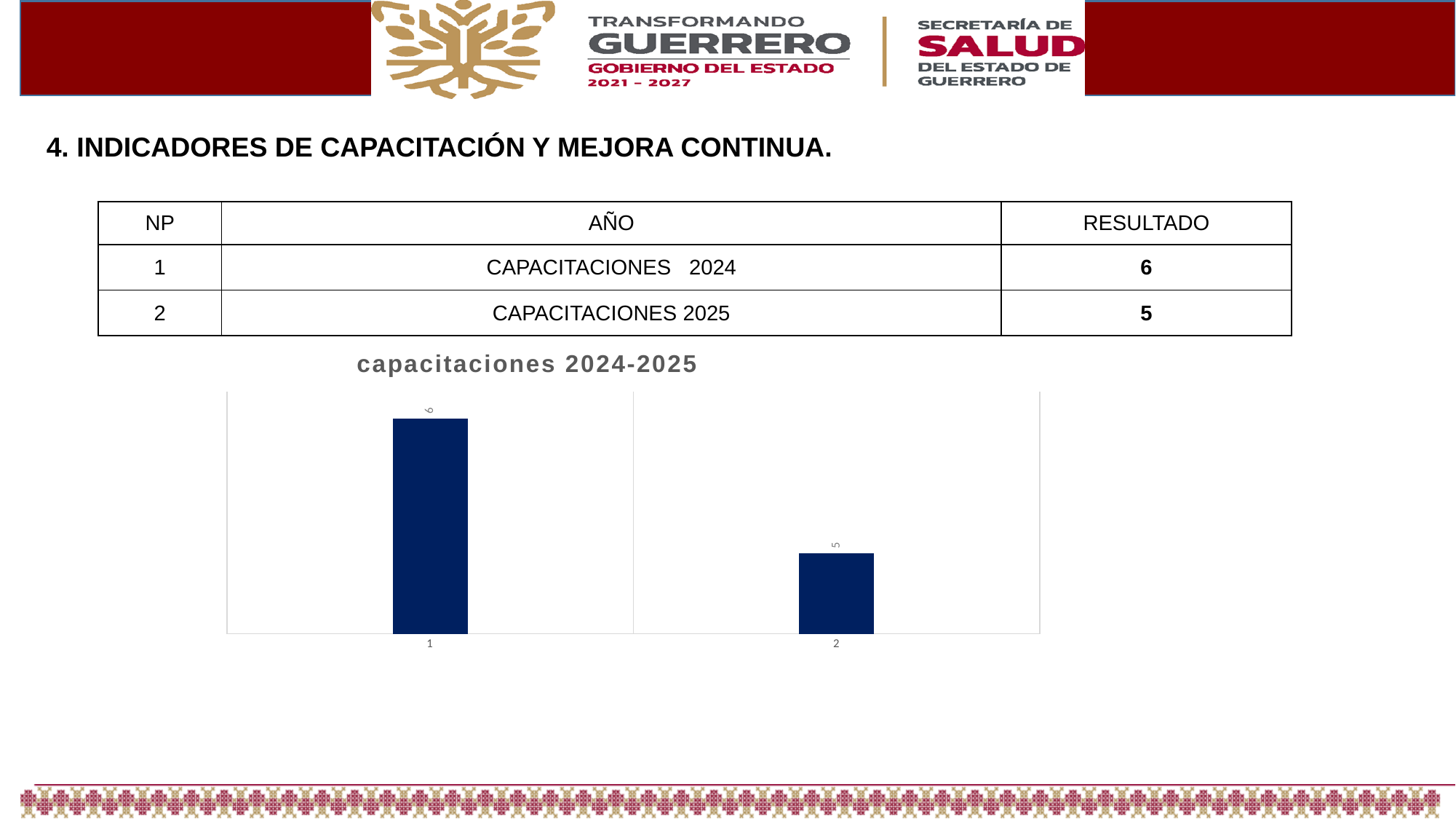
What is the value of the bar for category 1? 6 Which is larger, the value for category 1 or category 2? category 1 How many bars are plotted in the chart? 2 What type of chart is shown on the slide? bar chart What is the title of the chart? capacitaciones 2024-2025 Do the values rise or fall from category 1 to category 2? fall Which category has the highest bar? 1 What is the value of the bar for category 2? 5 Which category has the lowest bar? 2 What colour are the bars in the chart? dark blue What is the difference between the values for category 1 and category 2? 1